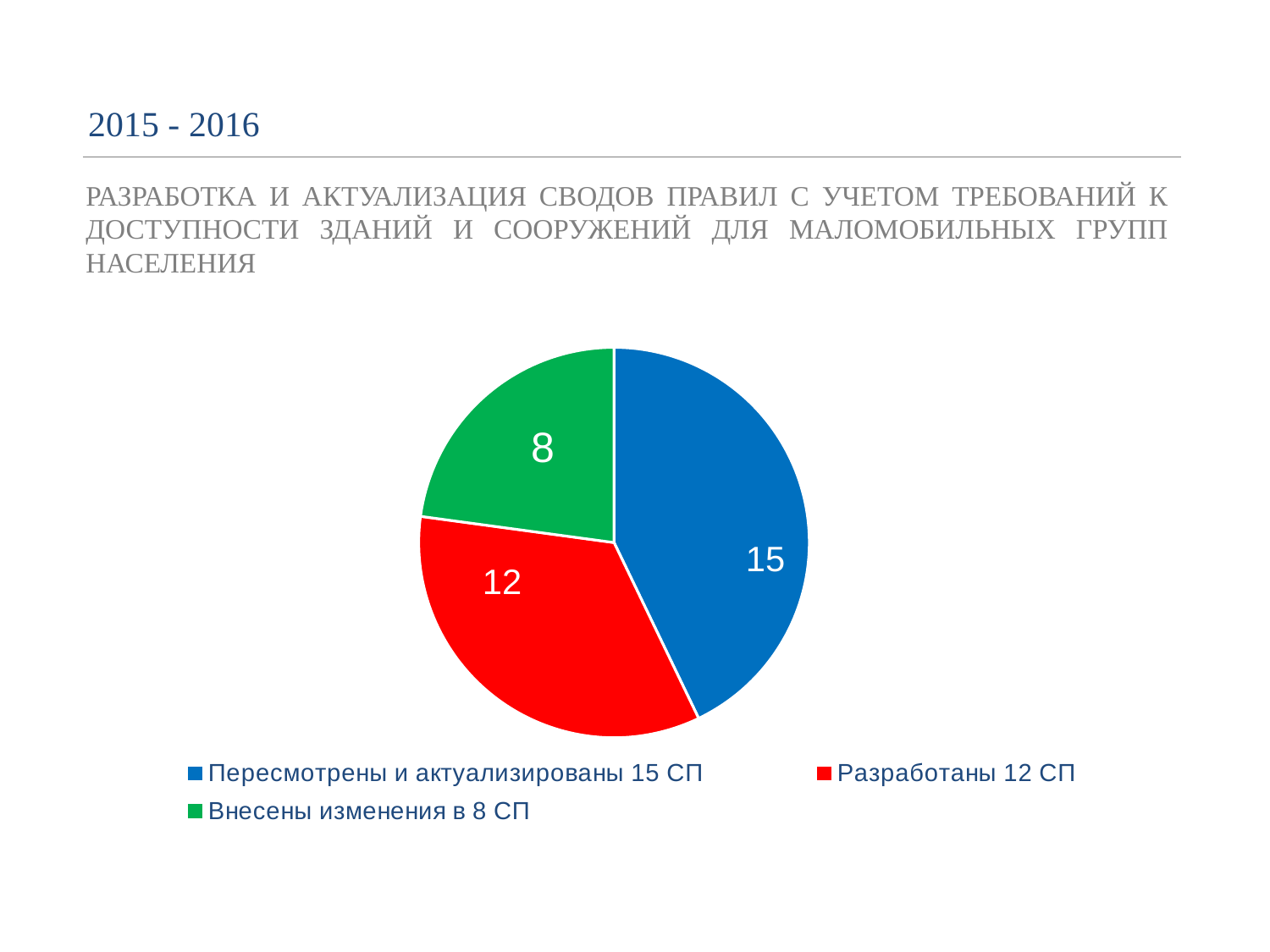
How many slices does the pie chart have? 3 What is the value of the slice labelled "Пересмотрены и актуализированы 15 СП"? 15 Which is larger: the value for "Разработаны 12 СП" or the value for "Внесены изменения в 8 СП"? Разработаны 12 СП Which slice of the pie chart is the largest? Пересмотрены и актуализированы 15 СП What kind of chart is shown on the slide? Pie chart Which slice of the pie chart is the smallest? Внесены изменения в 8 СП What is the value of the slice labelled "Внесены изменения в 8 СП"? 8 How many entries does the legend of the pie chart list? 3 What colour is the slice for "Внесены изменения в 8 СП"? Green What is the difference between the value for "Пересмотрены и актуализированы 15 СП" and the value for "Разработаны 12 СП"? 3 What is the total of all the slices in the pie chart? 35 What is the value of the slice labelled "Разработаны 12 СП"? 12